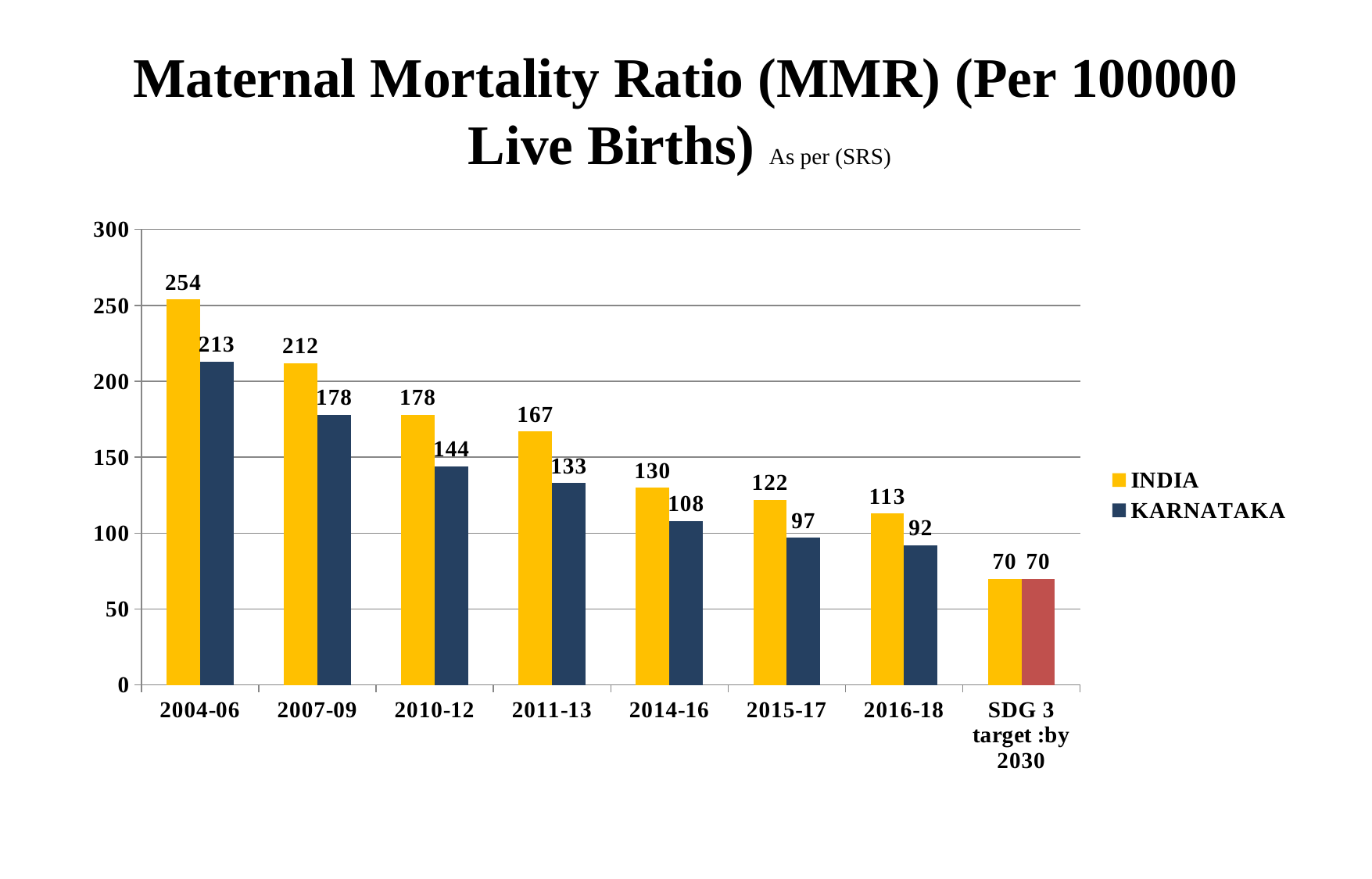
What is the SDG 3 target value by 2030 shown for INDIA? 70 Do the KARNATAKA values rise or fall from 2004-06 to 2016-18? Fall What is the difference between the INDIA and KARNATAKA values in 2014-16? 22 Which period has the highest MMR value for INDIA? 2004-06 Which is larger in 2015-17, the INDIA value or the KARNATAKA value? INDIA What is the MMR value for INDIA in 2004-06? 254 How many series does the legend list? 2 Excluding the SDG 3 target, which period has the lowest MMR value for KARNATAKA? 2016-18 What is the MMR value for KARNATAKA in 2016-18? 92 What kind of chart is shown on the slide? Bar chart What is the MMR value for KARNATAKA in 2010-12? 144 How many categories are shown on the x axis? 8